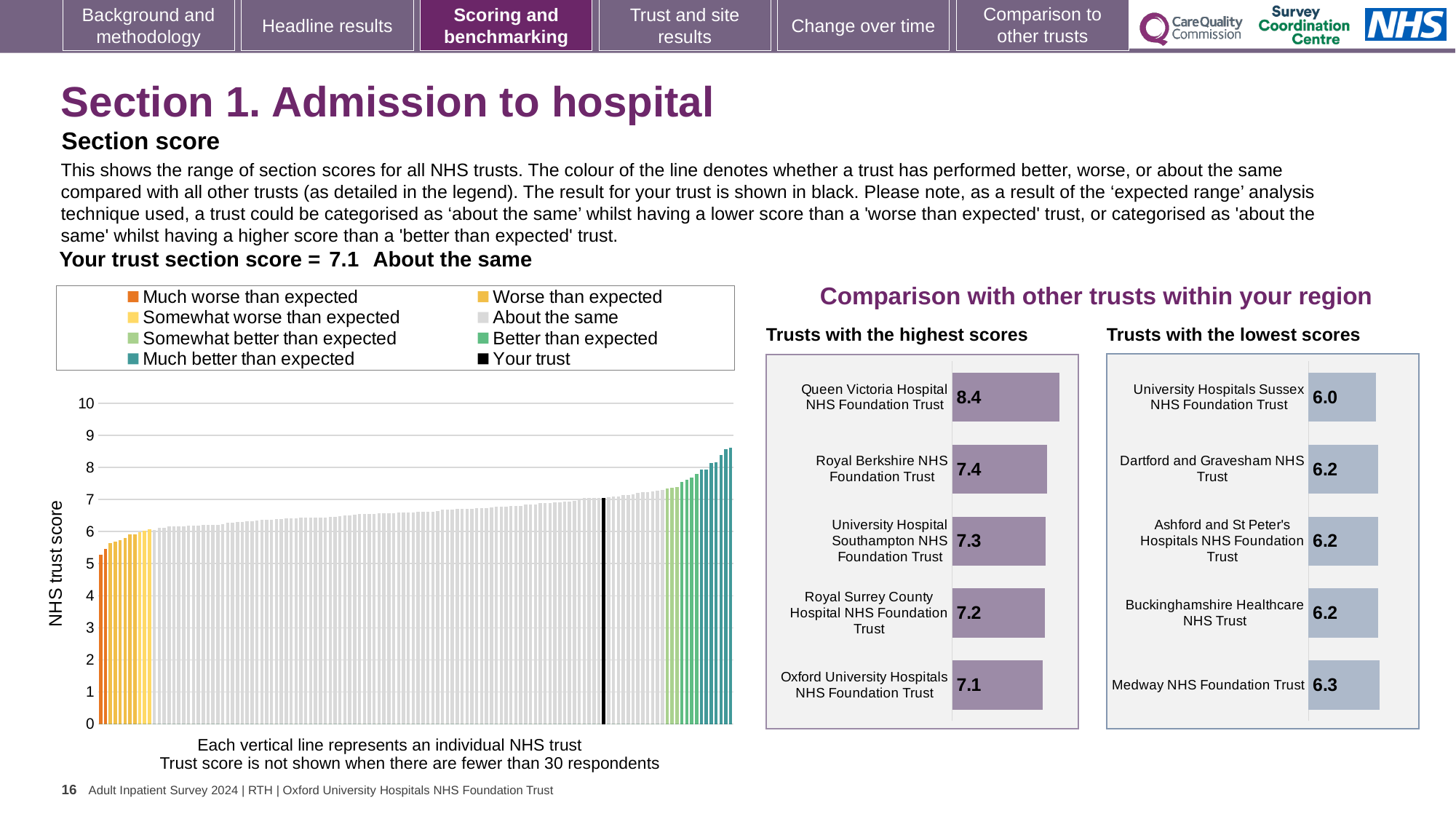
In the 'Trusts with the highest scores' chart, what is the difference between the scores of Queen Victoria Hospital NHS Foundation Trust and Oxford University Hospitals NHS Foundation Trust? 1.3 How many trusts are listed in the 'Trusts with the lowest scores' chart? 5 In the main NHS trust score chart on the left, do the trust scores rise or fall from left to right? Rise In the 'Trusts with the lowest scores' chart, what is the difference between the scores of Medway NHS Foundation Trust and University Hospitals Sussex NHS Foundation Trust? 0.3 In the main NHS trust score chart on the left, what is the section score for your trust? 7.1 In the 'Trusts with the highest scores' chart, which has the larger score: Royal Berkshire NHS Foundation Trust or Royal Surrey County Hospital NHS Foundation Trust? Royal Berkshire NHS Foundation Trust In the 'Trusts with the lowest scores' chart, what is the score for Medway NHS Foundation Trust? 6.3 How many entries does the legend of the main NHS trust score chart list? 8 In the 'Trusts with the highest scores' chart, which trust has the highest score? Queen Victoria Hospital NHS Foundation Trust In the 'Trusts with the highest scores' chart, what is the score for Queen Victoria Hospital NHS Foundation Trust? 8.4 What kind of chart is the main NHS trust score chart on the left? Bar chart In the 'Trusts with the lowest scores' chart, which trust has the lowest score? University Hospitals Sussex NHS Foundation Trust